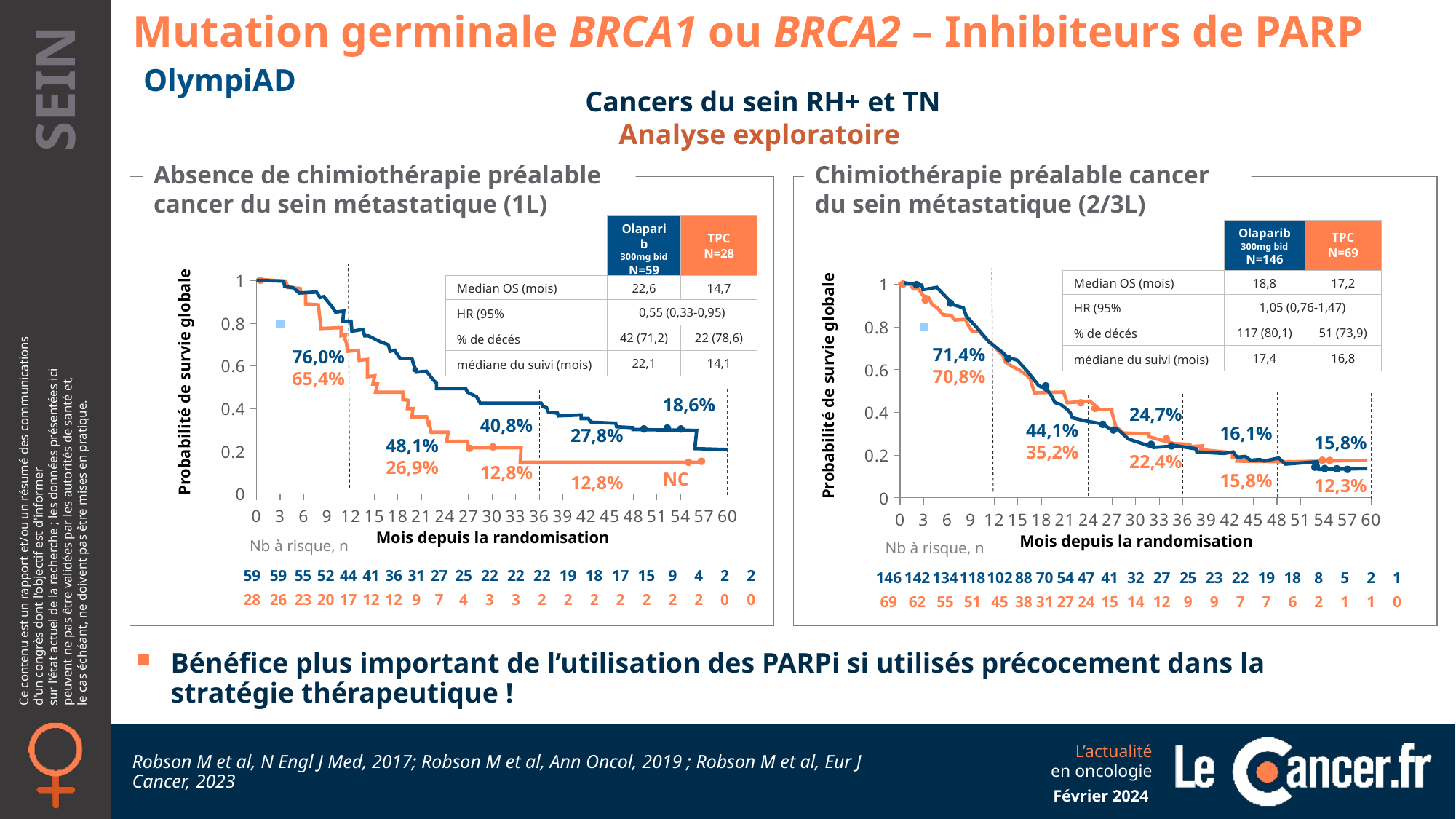
In the left chart (Absence de chimiothérapie préalable, 1L), what is the labelled overall survival probability for TPC at 24 months? 26,9% In the right chart (Chimiothérapie préalable, 2/3L), what is the HR (95%) shown in the inset table? 1,05 (0,76-1,47) In the left chart (Absence de chimiothérapie préalable, 1L), what is the labelled survival probability for Olaparib at 60 months? 18,6% In the right chart (Chimiothérapie préalable, 2/3L), what is the difference between the Olaparib and TPC labelled survival probabilities at 24 months? 8,9% In the right chart (Chimiothérapie préalable, 2/3L), what is the labelled survival probability for Olaparib at 60 months? 15,8% In the left chart (Absence de chimiothérapie préalable, 1L), what is the median OS in months for the Olaparib arm according to the inset table? 22,6 How many treatment arms (curves) are plotted in the right chart (Chimiothérapie préalable, 2/3L)? 2 In the left chart (Absence de chimiothérapie préalable, 1L), what is the labelled overall survival probability for Olaparib at 12 months? 76,0% What type of chart is shown in each of the two panels on the slide? Kaplan-Meier survival curve (line chart) In the left chart (Absence de chimiothérapie préalable, 1L), what is the difference between the Olaparib and TPC labelled survival probabilities at 36 months? 28,0% In the right chart (Chimiothérapie préalable, 2/3L), what is the labelled survival probability for TPC at 36 months? 22,4% In the left chart (Absence de chimiothérapie préalable, 1L), which arm has the higher labelled survival probability at 24 months, Olaparib or TPC? Olaparib